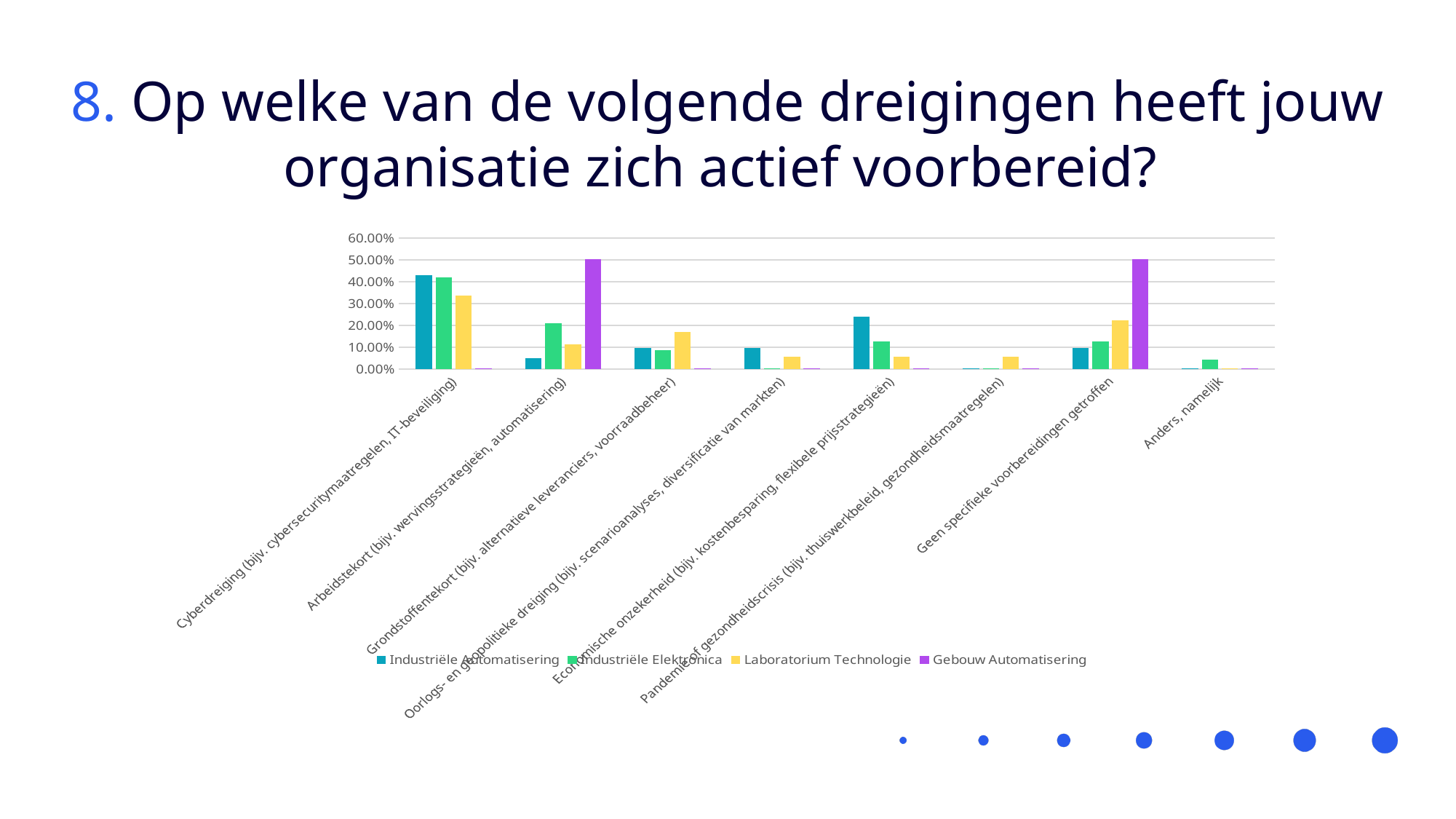
Is the value for Industriële Automatisering in the Cyberdreiging category greater or less than 40.00%? greater What colour represents the Gebouw Automatisering series in the legend? purple What is the value for Gebouw Automatisering in the category 'Geen specifieke voorbereidingen getroffen'? 50.00% Which series has the highest value in the Arbeidstekort category? Gebouw Automatisering Which series has the lowest value in the Grondstoffentekort category? Gebouw Automatisering Is the value for Laboratorium Technologie in the Cyberdreiging category greater or less than 30.00%? greater In the Cyberdreiging category, which is larger: Industriële Automatisering or Laboratorium Technologie? Industriële Automatisering How many categories are shown on the x axis? 8 How many series does the legend list? 4 In which category does Industriële Automatisering reach its highest value? Cyberdreiging (bijv. cybersecuritymaatregelen, IT-beveiliging) Is the value for Industriële Automatisering in the Pandemie of gezondheidscrisis category greater or less than 20.00%? less What kind of chart is shown on the slide? bar chart